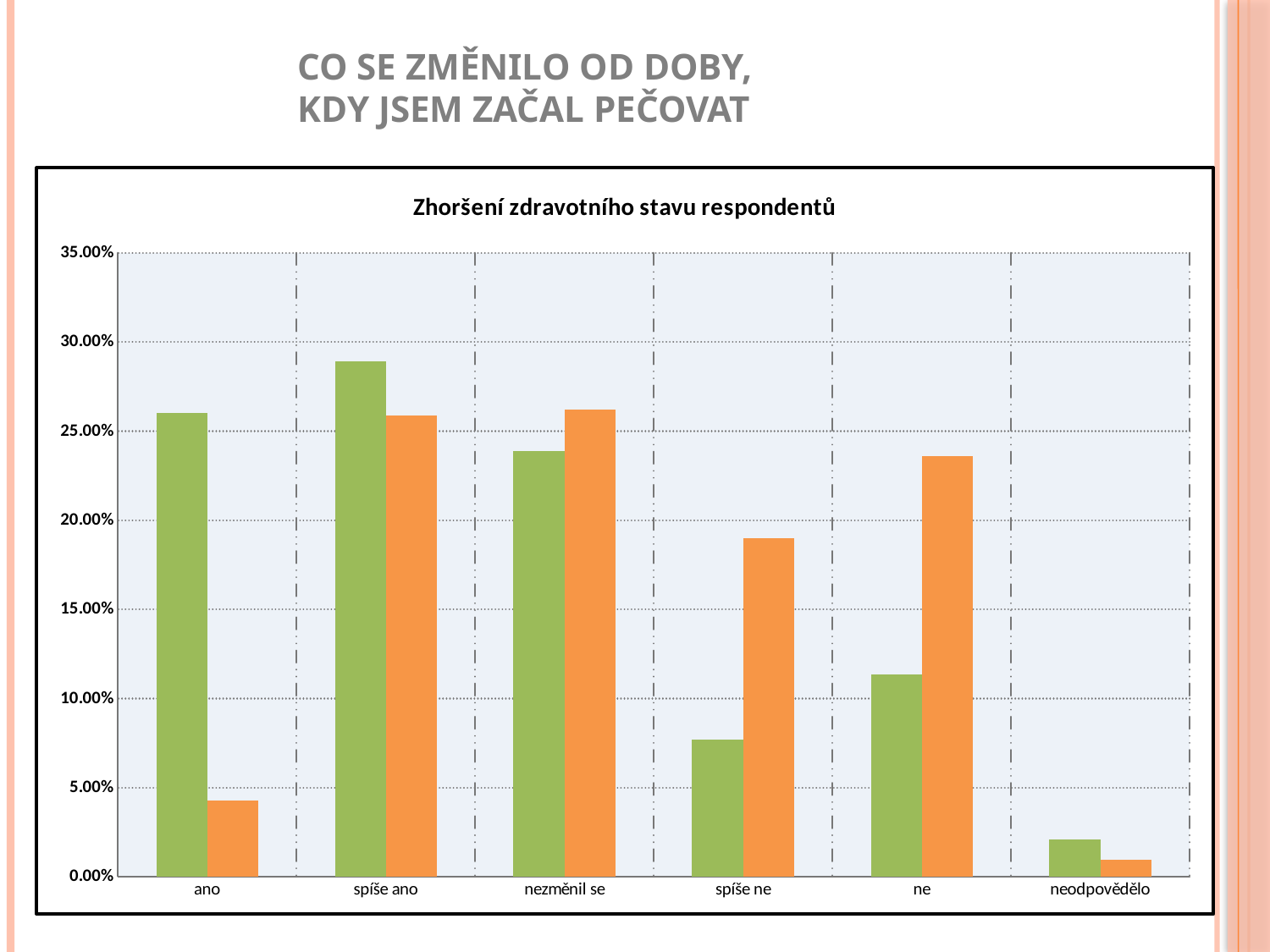
What is the title of the chart? Zhoršení zdravotního stavu respondentů For the category 'spíše ne', which bar is taller, the green one or the orange one? orange Which category has the shortest orange bar? neodpovědělo For the category 'ano', which bar is taller, the green one or the orange one? green Which category has the shortest green bar? neodpovědělo Which category has the tallest green bar? spíše ano Is the orange bar for 'ne' greater or less than 20.00%? greater Is the green bar for 'spíše ano' greater or less than 25.00%? greater How many bars are plotted for each category in the chart? 2 Is the orange bar for 'ano' greater or less than 5.00%? less How many categories are shown on the x axis of the chart? 6 What type of chart is shown on the slide? bar chart